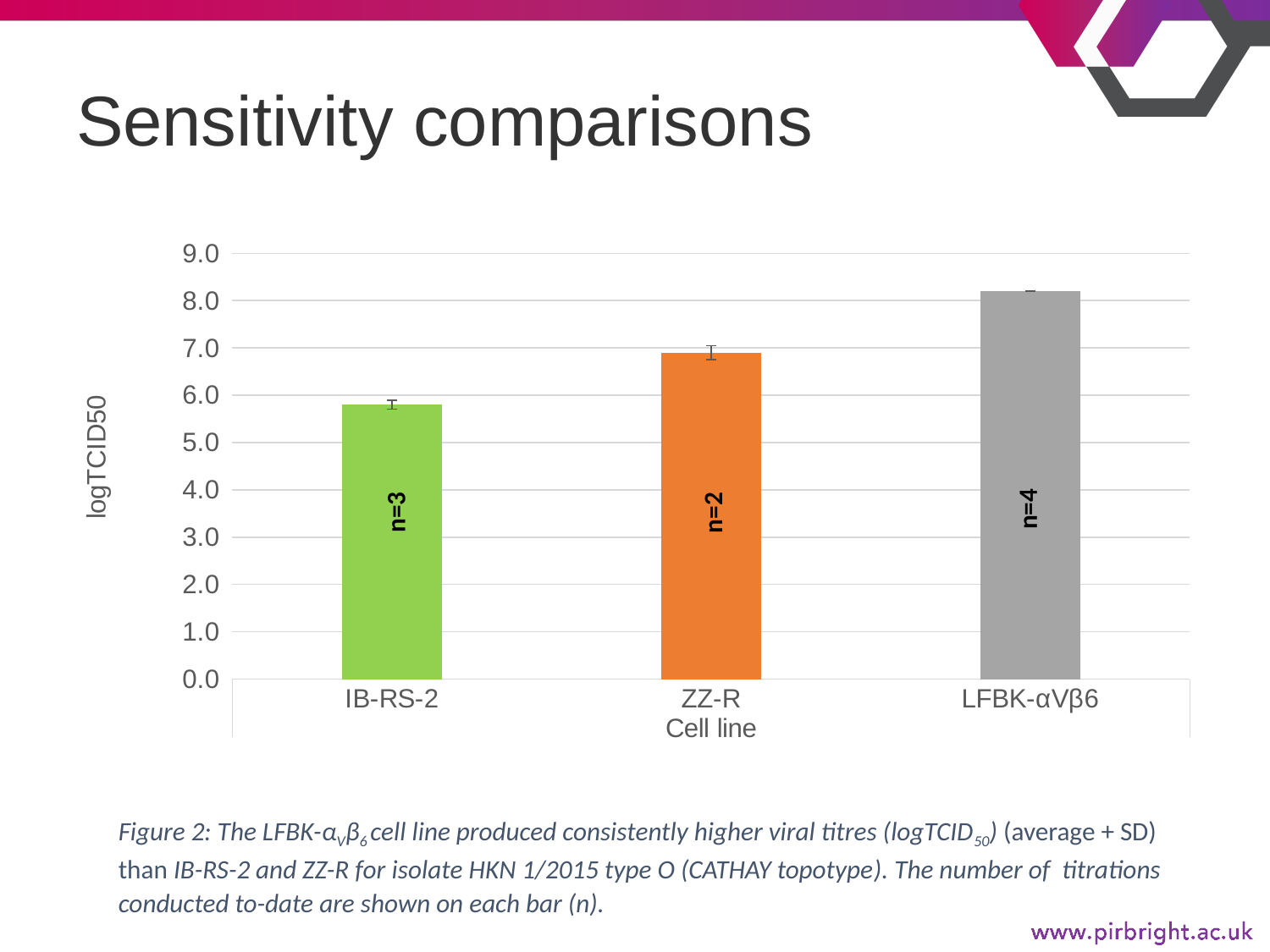
How many cell lines are plotted on the chart? 3 What is the n value printed on the ZZ-R bar? n=2 Is the value for IB-RS-2 greater or less than 6.0? less What is the n value printed on the LFBK-αVβ6 bar? n=4 Is the value for ZZ-R greater or less than 6.0? greater Is the value for LFBK-αVβ6 greater or less than 8.0? greater Do the bar values rise or fall from left to right across the cell lines? rise Which has a higher logTCID50 value, ZZ-R or IB-RS-2? ZZ-R What is the label of the vertical axis? logTCID50 Which cell line has the highest logTCID50 value? LFBK-αVβ6 Which cell line has the lowest logTCID50 value? IB-RS-2 What kind of chart is shown on the slide? bar chart